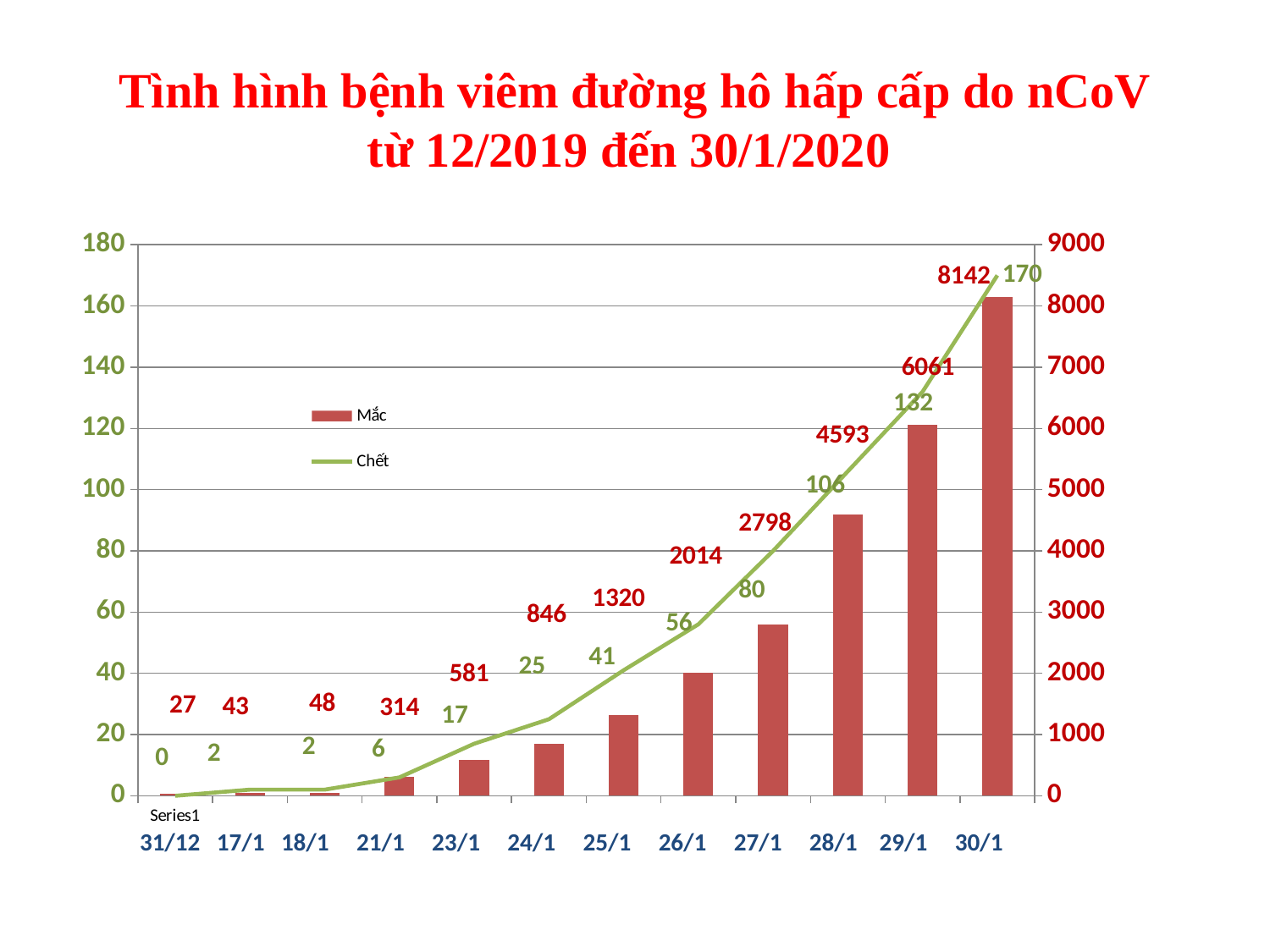
Which is larger, the Mắc value for 28/1 or for 27/1? 28/1 Which date has the highest Mắc value? 30/1 Which date has the lowest Chết value? 31/12 Do the Chết values rise or fall from 31/12 to 30/1? rise What is the Mắc value for 30/1? 8142 How many dates are shown on the x axis? 12 How many series does the legend list? 2 What is the difference between the Chết values for 27/1 and 26/1? 24 What is the Mắc value for 25/1? 1320 What is the Chết value for 23/1? 17 What is the difference between the Mắc values for 30/1 and 29/1? 2081 What is the Chết value for 28/1? 106